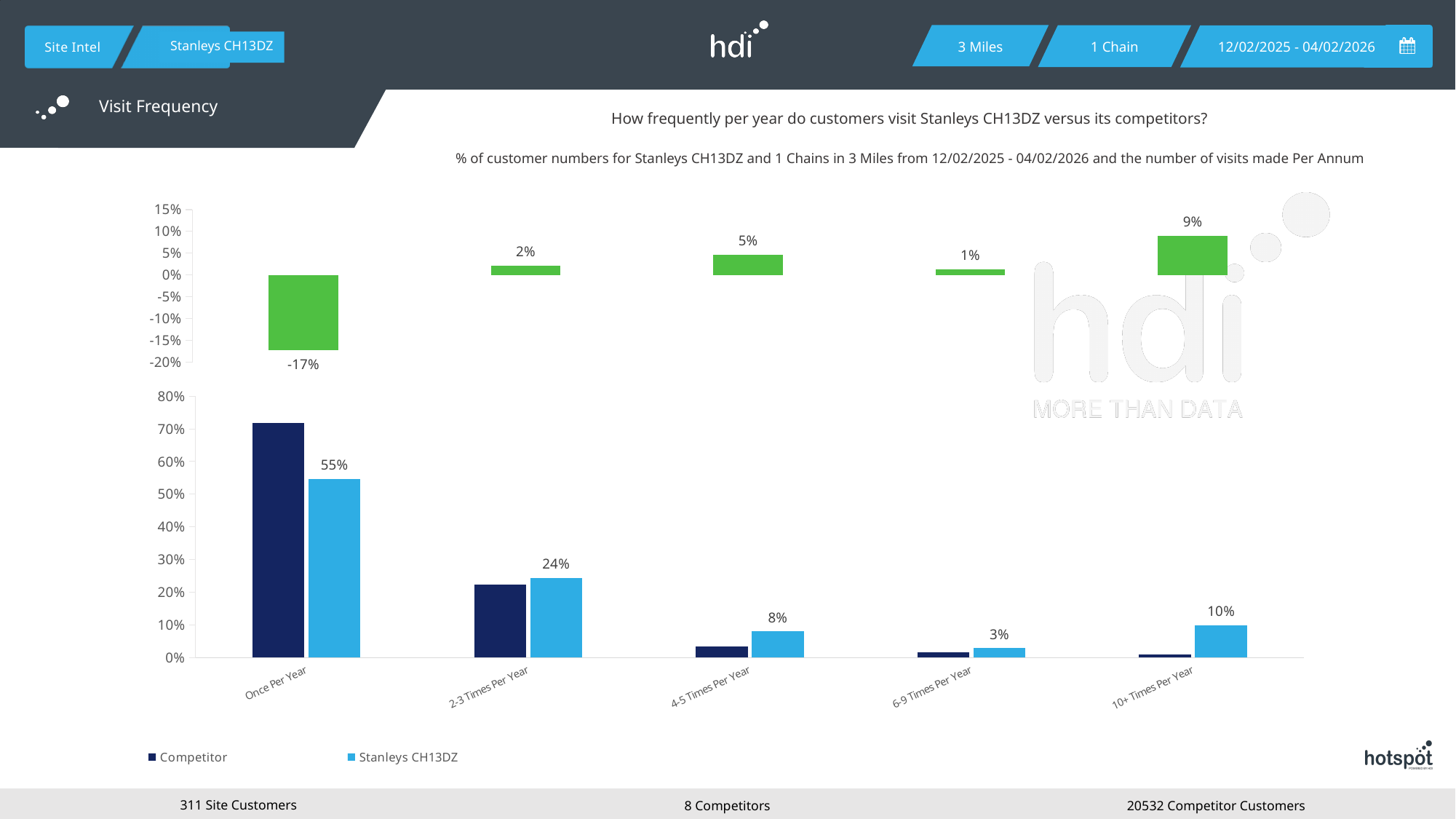
In the top chart, which category has the lowest value? Once Per Year In the bottom chart, what is the difference between the Stanleys CH13DZ values for Once Per Year and 2-3 Times Per Year? 31% In the top chart, which category has the highest value? 10+ Times Per Year In the top chart, what is the value shown for Once Per Year? -17% In the bottom chart, what is the value for Stanleys CH13DZ for Once Per Year? 55% In the bottom chart, which category has the lowest value for Stanleys CH13DZ? 6-9 Times Per Year In the bottom chart, which is larger for 2-3 Times Per Year: Competitor or Stanleys CH13DZ? Stanleys CH13DZ In the bottom chart, what is the value for Stanleys CH13DZ for 10+ Times Per Year? 10% How many series does the legend of the bottom chart list? 2 In the bottom chart, is the Competitor value for Once Per Year greater or less than 60%? greater In the bottom chart, what is the value for Stanleys CH13DZ for 2-3 Times Per Year? 24% What kind of chart is the bottom chart? bar chart